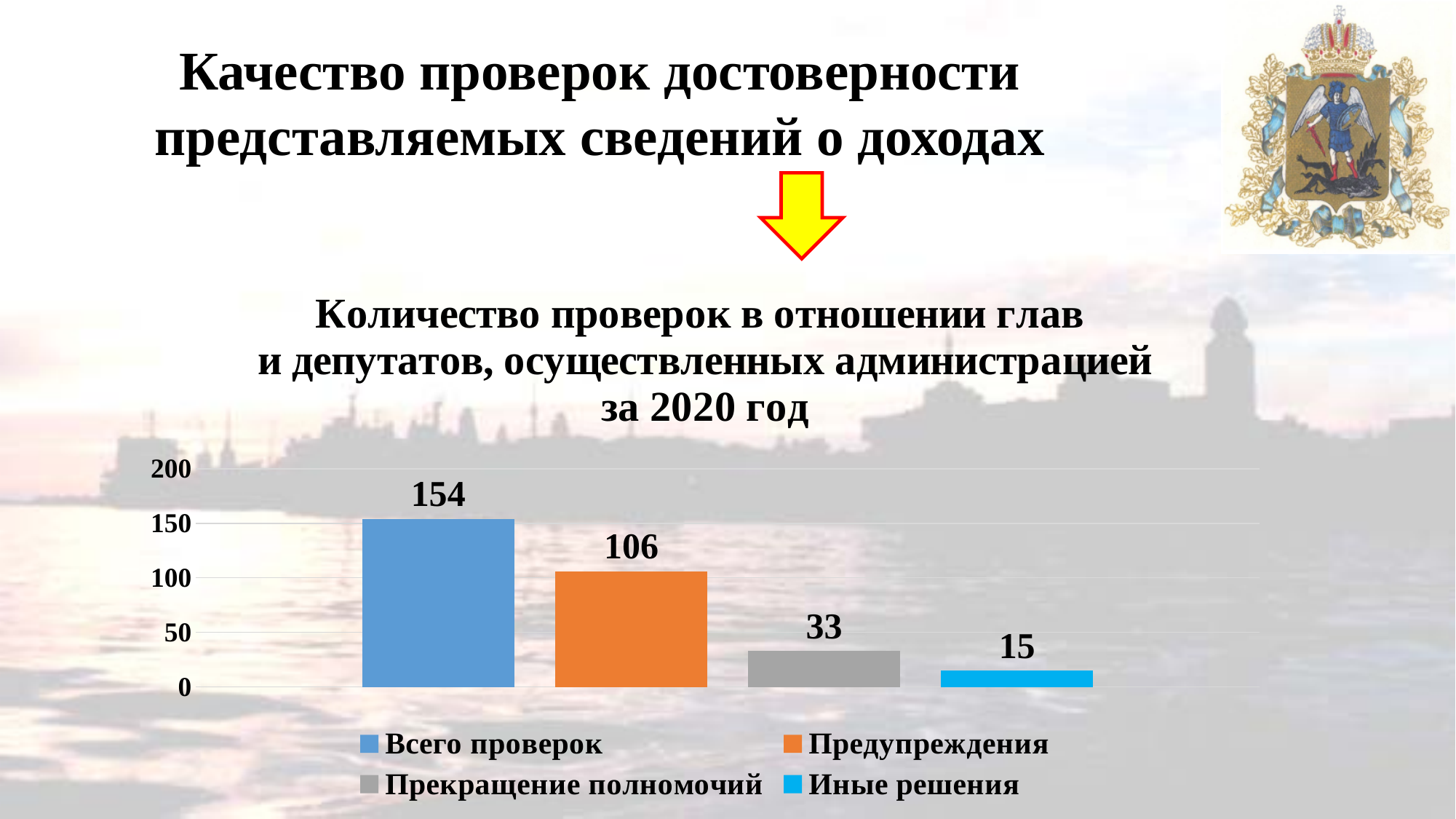
What is the value for Предупреждения? 106 What kind of chart is shown on the slide? Bar chart What is the value for Иные решения? 15 What is the difference between Всего проверок and Предупреждения? 48 What colour is the bar for Предупреждения? Orange Which category has the lowest value? Иные решения What is the value for Всего проверок? 154 What is the value for Прекращение полномочий? 33 Which category has the highest value? Всего проверок What is the difference between Прекращение полномочий and Иные решения? 18 How many series does the legend list? 4 Which is larger, Предупреждения or Прекращение полномочий? Предупреждения